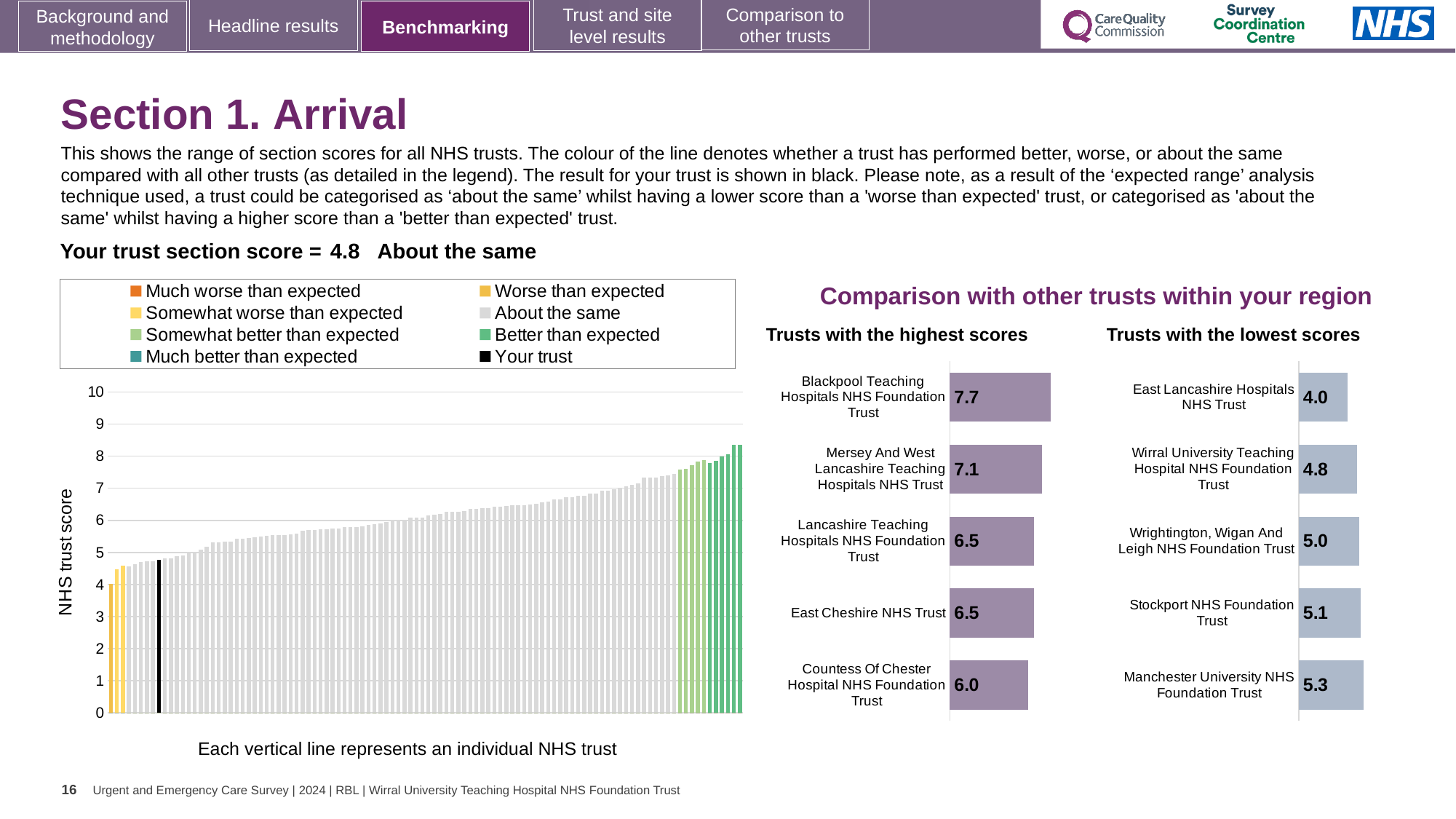
What kind of chart is the main chart on the left showing NHS trust scores? Bar chart In the 'Trusts with the highest scores' chart, what is the score for Countess Of Chester Hospital NHS Foundation Trust? 6.0 In the main NHS trust score chart, is the value for the black 'Your trust' bar greater or less than 5? less How many trusts are shown in the 'Trusts with the lowest scores' chart? 5 In the 'Trusts with the lowest scores' chart, which trust has the lowest score? East Lancashire Hospitals NHS Trust In the 'Trusts with the highest scores' chart, what is the difference between the scores of Blackpool Teaching Hospitals NHS Foundation Trust and Countess Of Chester Hospital NHS Foundation Trust? 1.7 In the 'Trusts with the lowest scores' chart, which has the larger score: Stockport NHS Foundation Trust or Wrightington, Wigan And Leigh NHS Foundation Trust? Stockport NHS Foundation Trust In the 'Trusts with the highest scores' chart, which trust has the highest score? Blackpool Teaching Hospitals NHS Foundation Trust In the 'Trusts with the highest scores' chart, what is the score for Blackpool Teaching Hospitals NHS Foundation Trust? 7.7 In the main NHS trust score chart, do the bars rise or fall from left to right? Rise How many entries does the legend of the main NHS trust score chart list? 8 In the 'Trusts with the lowest scores' chart, what is the score for East Lancashire Hospitals NHS Trust? 4.0